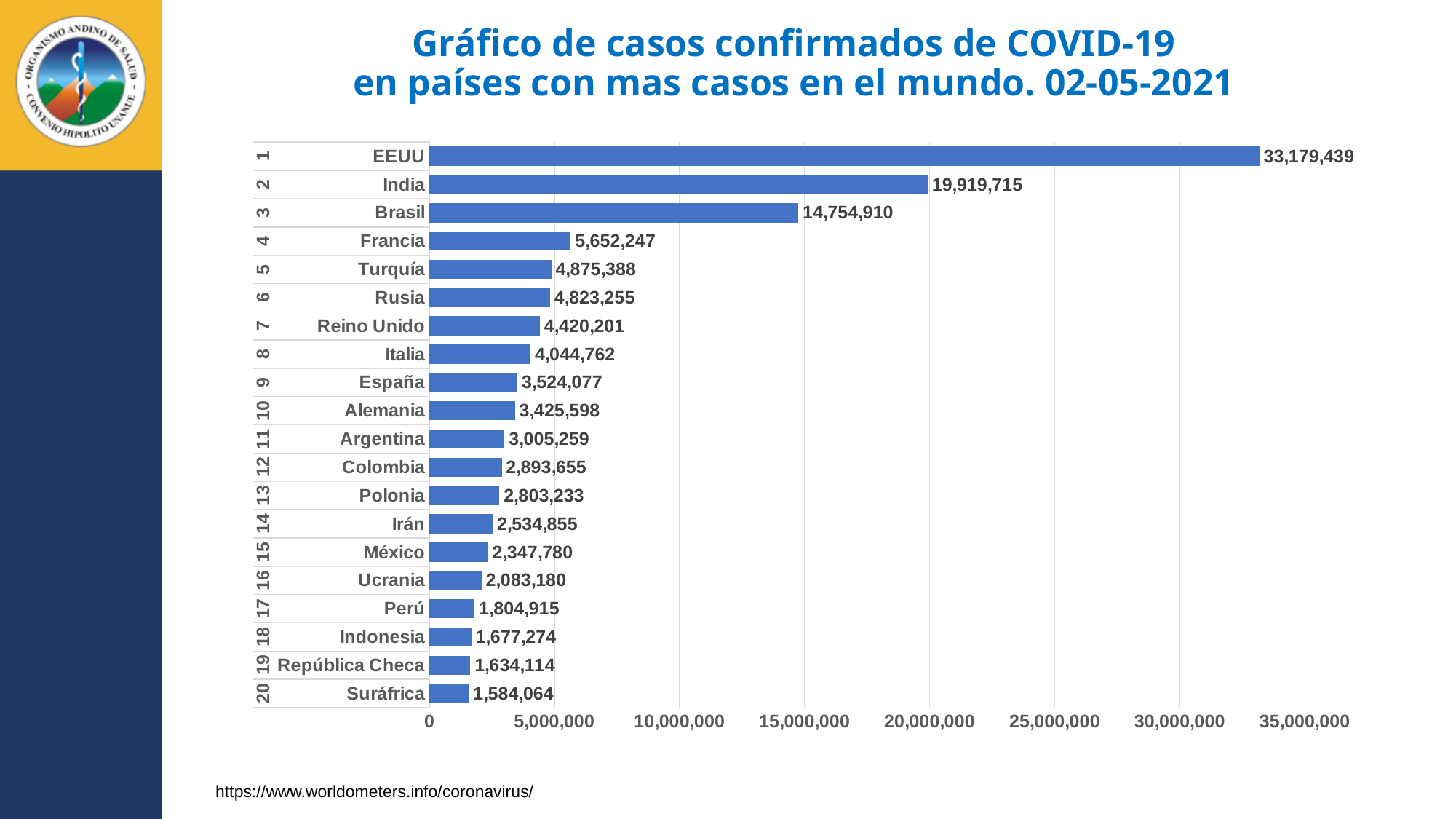
What is the difference in confirmed cases between EEUU and India? 13,259,724 What is the number of confirmed cases for Colombia? 2,893,655 What kind of chart is shown on the slide? bar chart Which country has the highest number of confirmed COVID-19 cases in the chart? EEUU How many countries are shown in the chart? 20 What is the number of confirmed cases for India? 19,919,715 What date is given in the chart title? 02-05-2021 Which has more confirmed cases, Turquía or Rusia? Turquía Is the value for Italia greater or less than 5,000,000? less What is the difference in confirmed cases between Brasil and Francia? 9,102,663 What is the number of confirmed cases for Perú? 1,804,915 Which country has the lowest number of confirmed cases in the chart? Suráfrica